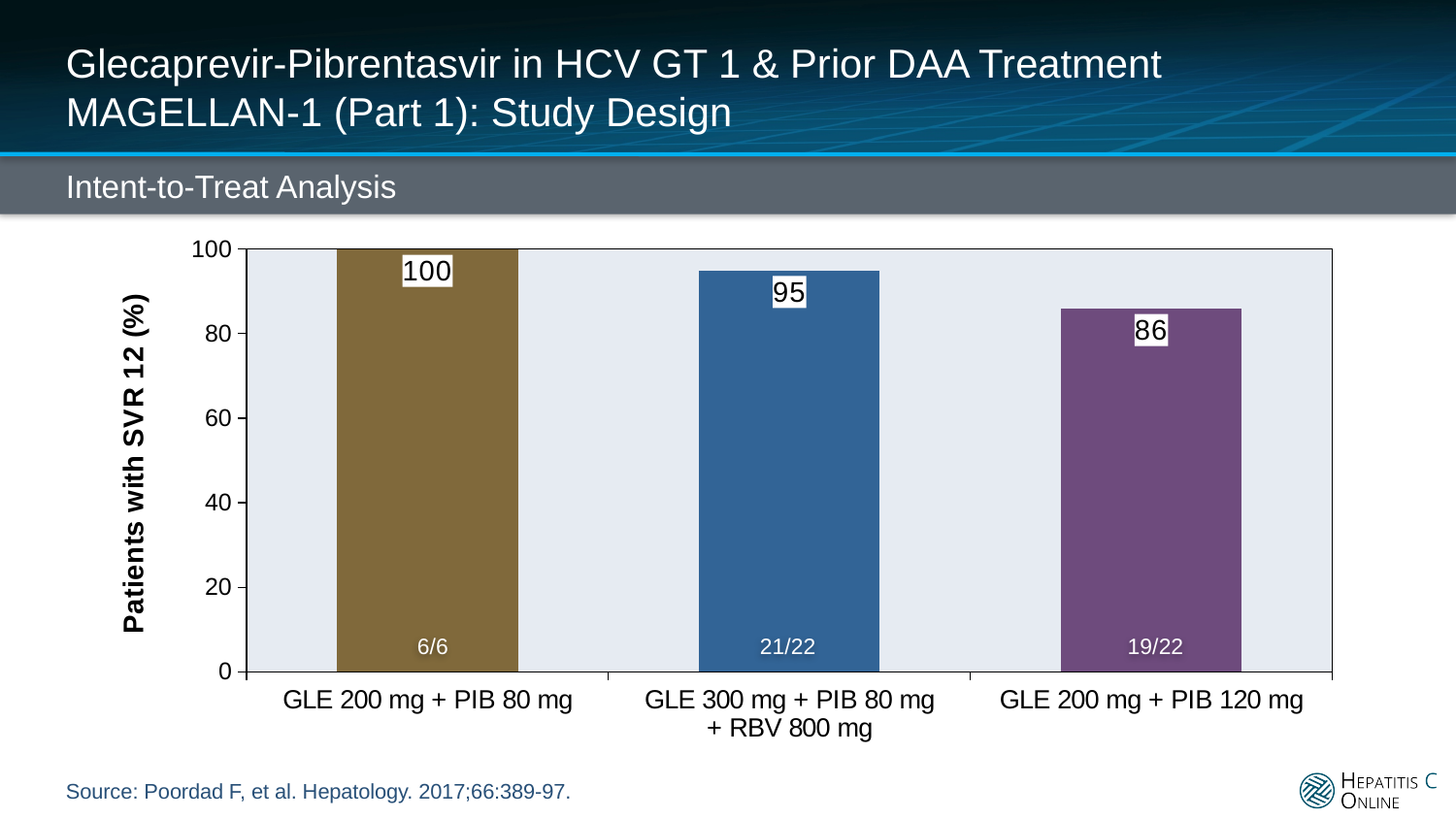
How many patients achieved SVR 12 out of the total in the GLE 300 mg + PIB 80 mg + RBV 800 mg arm? 21/22 What is the label of the y-axis? Patients with SVR 12 (%) Which treatment arm has the highest SVR 12 rate? GLE 200 mg + PIB 80 mg What is the SVR 12 rate for the GLE 300 mg + PIB 80 mg + RBV 800 mg arm? 95 What type of chart is shown on the slide? Bar chart Which treatment arm has the lowest SVR 12 rate? GLE 200 mg + PIB 120 mg What is the SVR 12 rate for the GLE 200 mg + PIB 80 mg arm? 100 Which arm has a higher SVR 12 rate: GLE 300 mg + PIB 80 mg + RBV 800 mg or GLE 200 mg + PIB 120 mg? GLE 300 mg + PIB 80 mg + RBV 800 mg What is the difference in SVR 12 rate between the GLE 200 mg + PIB 80 mg arm and the GLE 200 mg + PIB 120 mg arm? 14 How many patients achieved SVR 12 out of the total in the GLE 200 mg + PIB 120 mg arm? 19/22 What is the SVR 12 rate for the GLE 200 mg + PIB 120 mg arm? 86 How many treatment arms are shown in the chart? 3